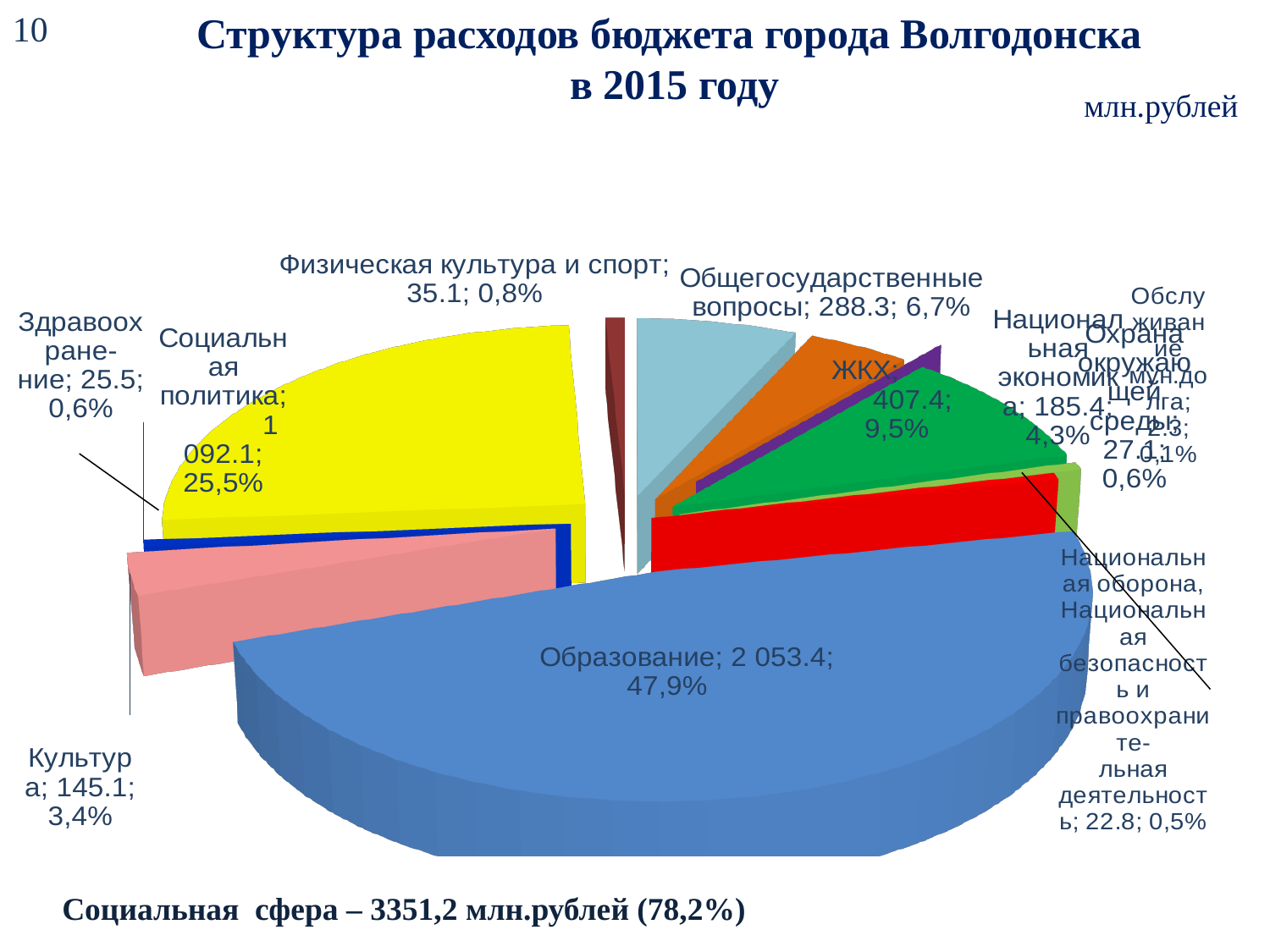
What is the difference between the values for Образование and Социальная политика? 961.3 Which is larger, the value for ЖКХ or the value for Общегосударственные вопросы? ЖКХ Which category has the largest slice of the pie? Образование In what units are the values on the chart given, according to the slide? млн.рублей What percentage is shown for Физическая культура и спорт? 0,8% What percentage is shown for ЖКХ? 9,5% What is the value for Культура? 145.1 What kind of chart is shown on the slide? pie chart What share of the pie does Образование represent? 47,9% What is the value for Образование? 2 053.4 What is the value for Социальная политика? 1 092.1 What is the value for Общегосударственные вопросы? 288.3